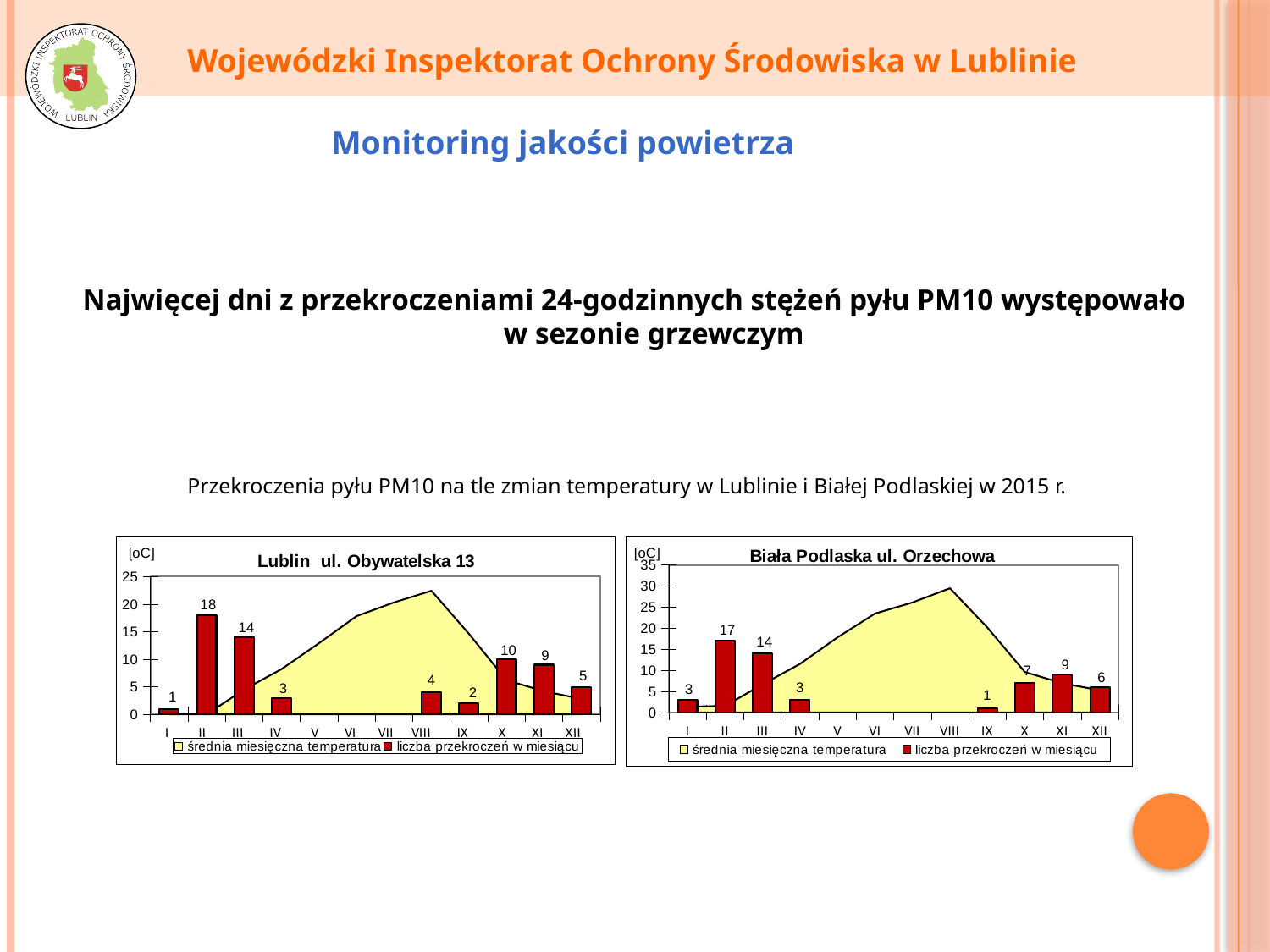
In the Lublin ul. Obywatelska 13 chart, how many exceedances (liczba przekroczeń w miesiącu) were recorded in month II? 18 In the Lublin ul. Obywatelska 13 chart, is the average monthly temperature in month VIII greater or less than 20? greater In the Lublin ul. Obywatelska 13 chart, what is the difference between the exceedances in month II and month III? 4 How many months are shown on the x axis of the Biała Podlaska ul. Orzechowa chart? 12 In the Lublin ul. Obywatelska 13 chart, which month has the highest number of exceedances? II How many series does the legend of the Lublin ul. Obywatelska 13 chart list? 2 In the Lublin ul. Obywatelska 13 chart, which month has more exceedances, X or XI? X In the Biała Podlaska ul. Orzechowa chart, how many exceedances were recorded in month XI? 9 In the Biała Podlaska ul. Orzechowa chart, is the average monthly temperature in month VIII greater or less than 25? greater In the Biała Podlaska ul. Orzechowa chart, does the average monthly temperature rise or fall from month I to month VIII? rise In the Biała Podlaska ul. Orzechowa chart, what is the difference between the exceedances in month II and month XII? 11 In the Biała Podlaska ul. Orzechowa chart, which month has the lowest non-zero number of exceedances? IX